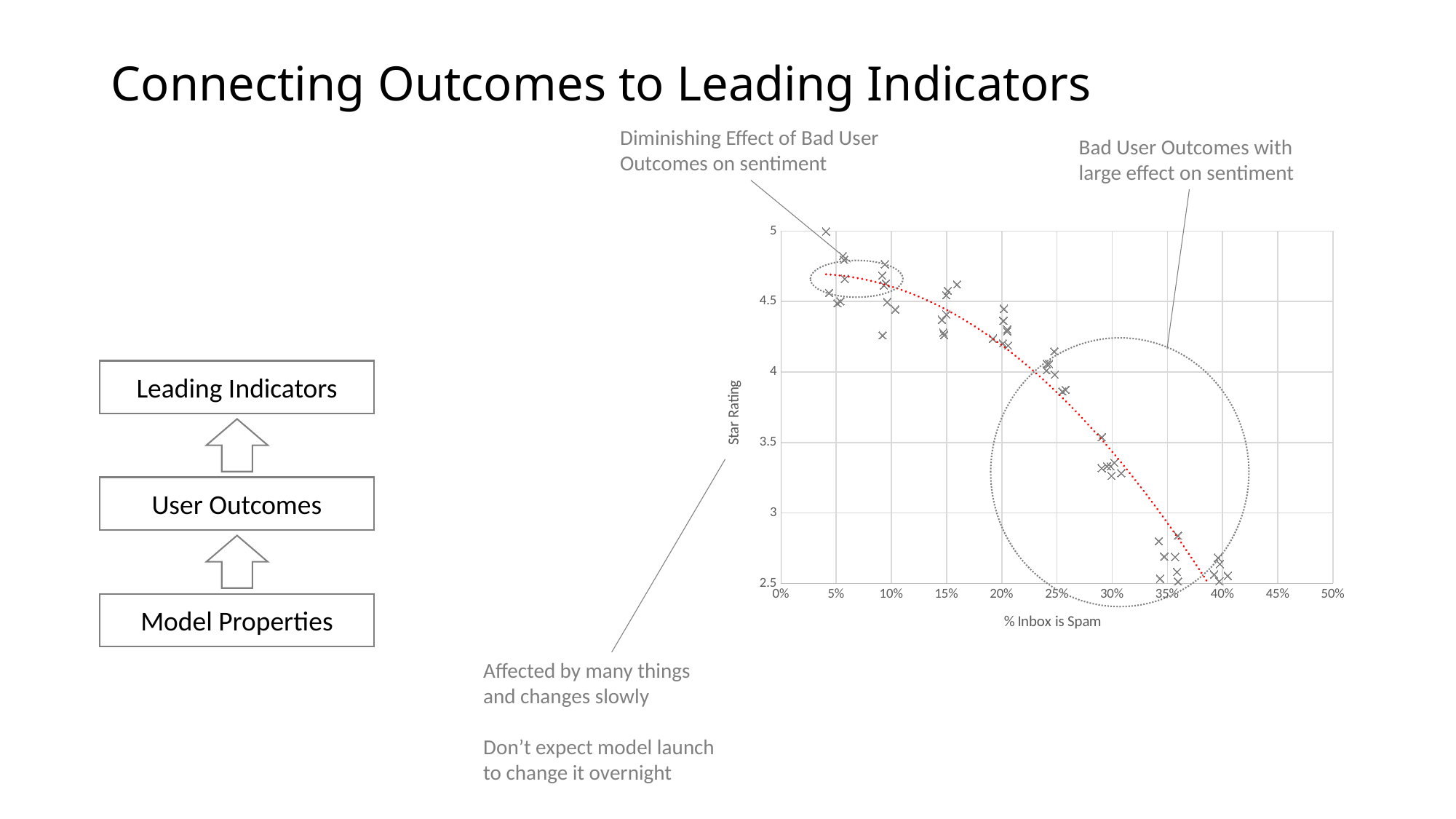
What is the label of the x axis of the chart? % Inbox is Spam Are the star ratings for the points at around 30% inbox spam greater or less than 4? less Is the highest star rating plotted on the chart greater or less than 4.5? greater What is the label of the y axis of the chart? Star Rating Are the star ratings for the points at around 25% inbox spam greater or less than 3.5? greater As % Inbox is Spam increases along the x axis, does Star Rating rise or fall? fall Which group of points has higher star ratings: those near 10% inbox spam or those near 35% inbox spam? those near 10% inbox spam What kind of chart is shown on the slide? scatter chart